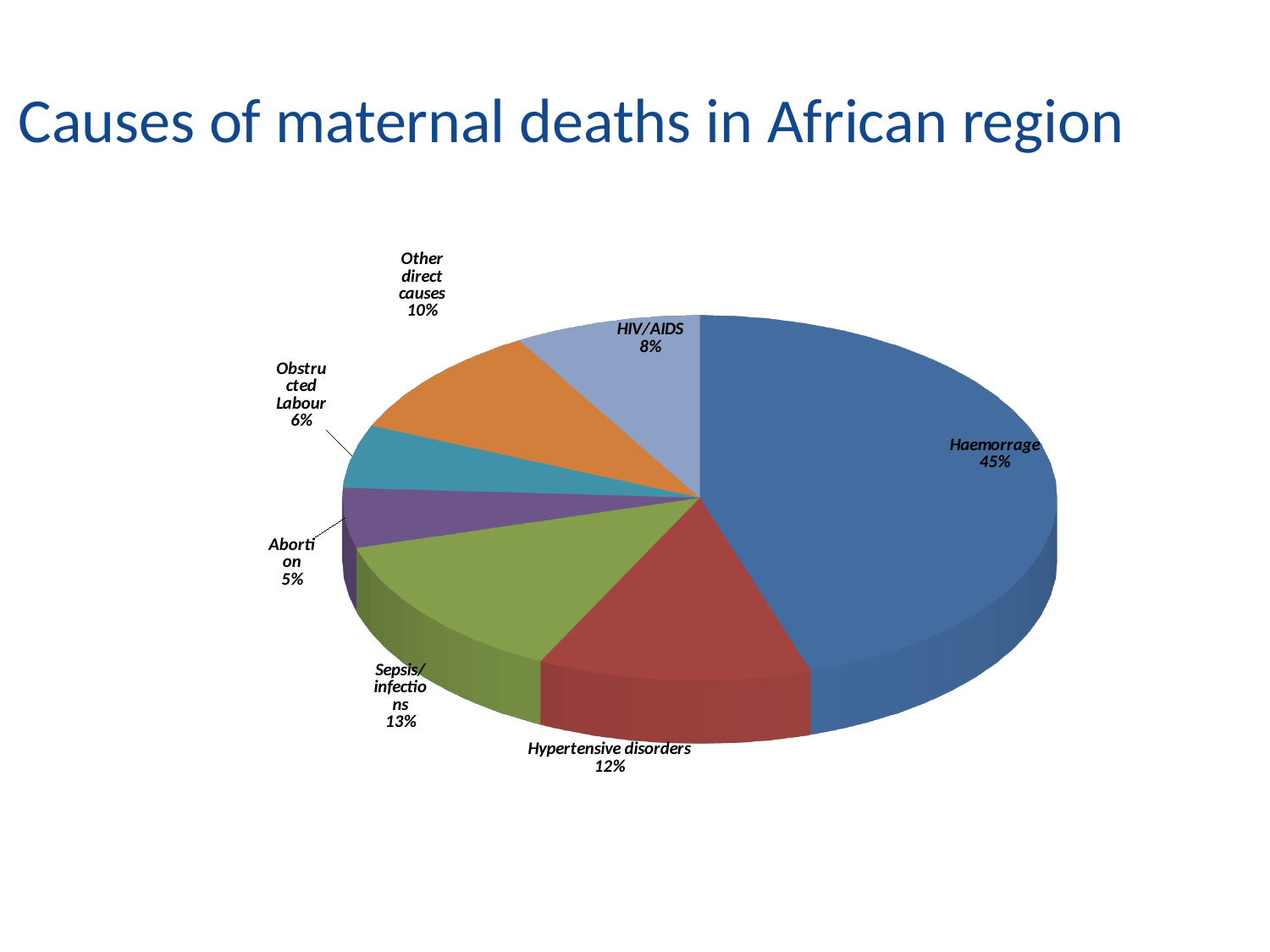
Which cause accounts for the smallest share of maternal deaths? Abortion What type of chart is shown on the slide? Pie chart What share is shown for HIV/AIDS? 8% What is the title of the slide? Causes of maternal deaths in African region How many causes are shown in the pie chart? 7 What percentage is shown for Obstructed Labour? 6% Which cause accounts for the largest share of maternal deaths? Haemorrage What is the difference in percentage points between Haemorrage and Sepsis/infections? 32 Which is larger, the share for Other direct causes or the share for HIV/AIDS? Other direct causes What percentage is shown for Hypertensive disorders? 12% What percentage of maternal deaths is due to Sepsis/infections? 13% What share of maternal deaths is attributed to Haemorrage? 45%